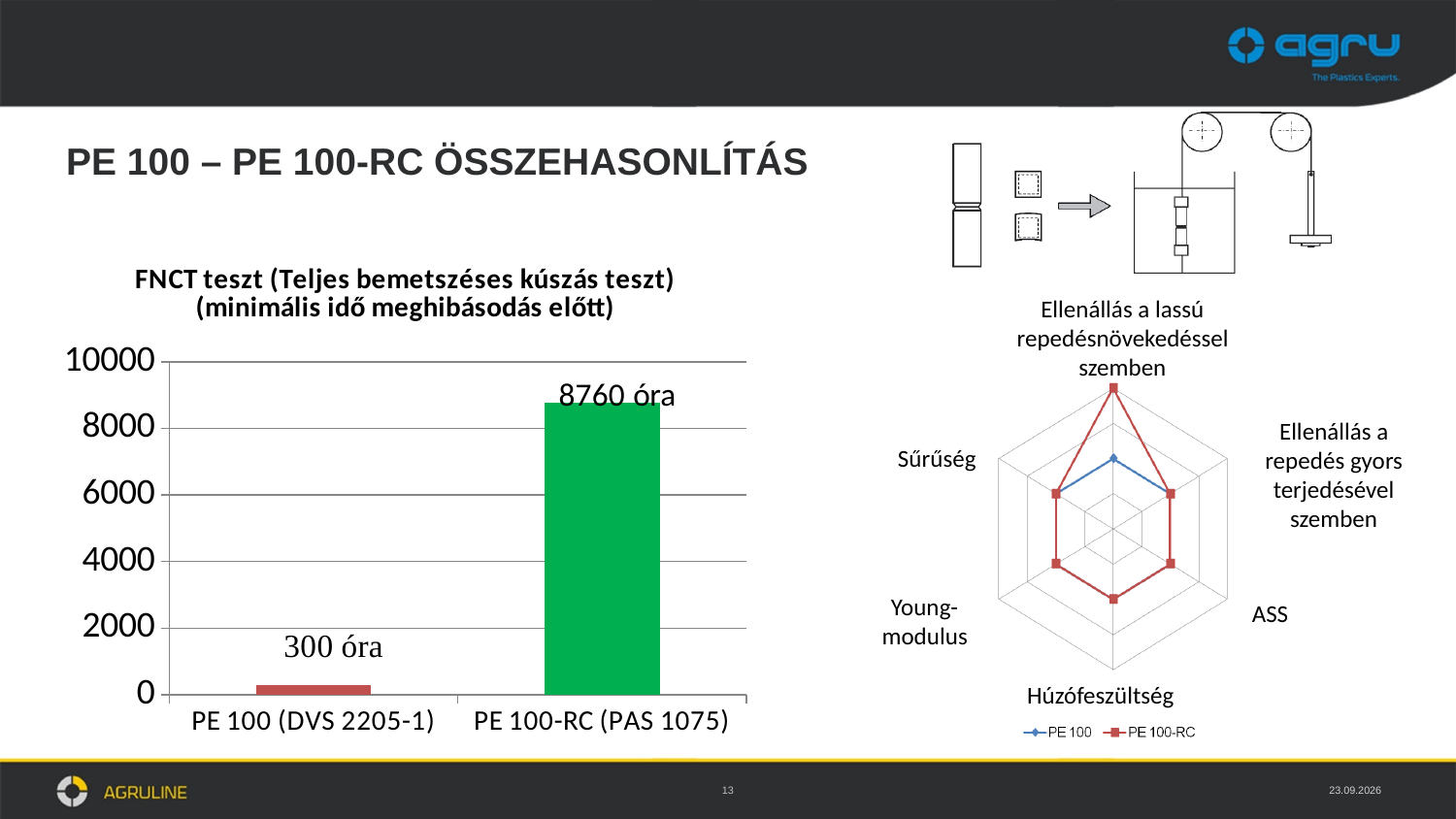
How many axes (categories) does the radar chart on the right have? 6 How many series does the legend of the radar chart on the right list? 2 In the FNCT teszt bar chart, which category has the lowest value? PE 100 (DVS 2205-1) How many categories are shown in the FNCT teszt bar chart? 2 In the FNCT teszt bar chart, what is the value for PE 100-RC (PAS 1075)? 8760 óra In the FNCT teszt bar chart, is the value for PE 100 (DVS 2205-1) greater or less than 2000? less What kind of chart is the FNCT teszt chart on the left of the slide? bar chart In the FNCT teszt bar chart, which category has the highest value? PE 100-RC (PAS 1075) In the FNCT teszt bar chart, what is the value for PE 100 (DVS 2205-1)? 300 óra What kind of chart is shown on the right side of the slide? radar chart In the FNCT teszt bar chart, what is the difference between the values for PE 100-RC (PAS 1075) and PE 100 (DVS 2205-1)? 8460 óra In the FNCT teszt bar chart, is the value for PE 100-RC (PAS 1075) greater or less than 8000? greater